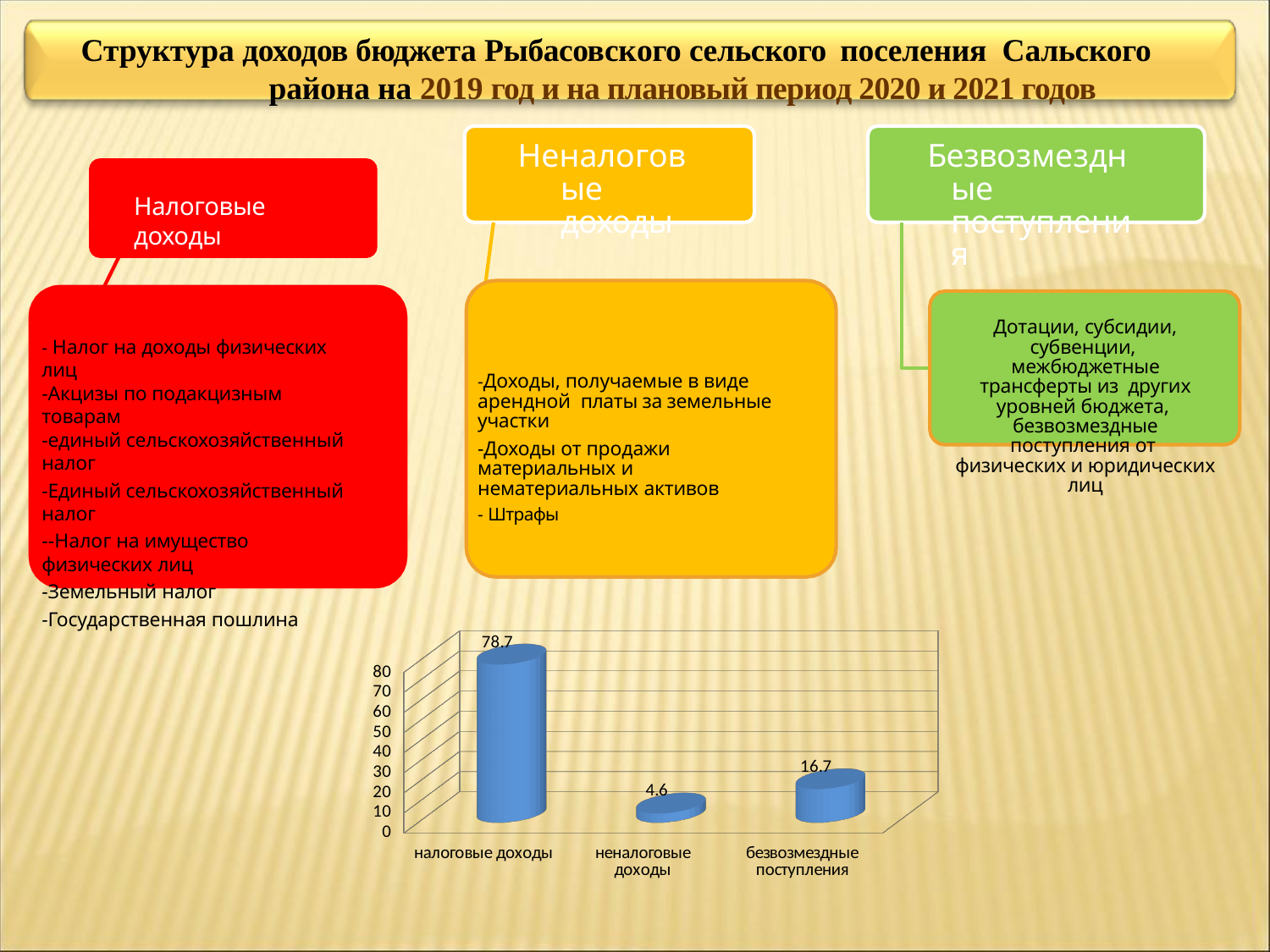
Which category has the highest value in the chart? налоговые доходы Which is larger, the value for безвозмездные поступления or the value for неналоговые доходы? безвозмездные поступления What is the value for налоговые доходы in the chart? 78.7 What is the value for неналоговые доходы in the chart? 4.6 What is the value for безвозмездные поступления in the chart? 16.7 What is the difference between the values for налоговые доходы and безвозмездные поступления? 62 Is the value for налоговые доходы greater or less than 70? greater How many categories are shown in the chart? 3 What is the highest value shown on the vertical axis of the chart? 80 What kind of chart is shown on the slide? bar chart Which category has the lowest value in the chart? неналоговые доходы What is the difference between the values for безвозмездные поступления and неналоговые доходы? 12.1